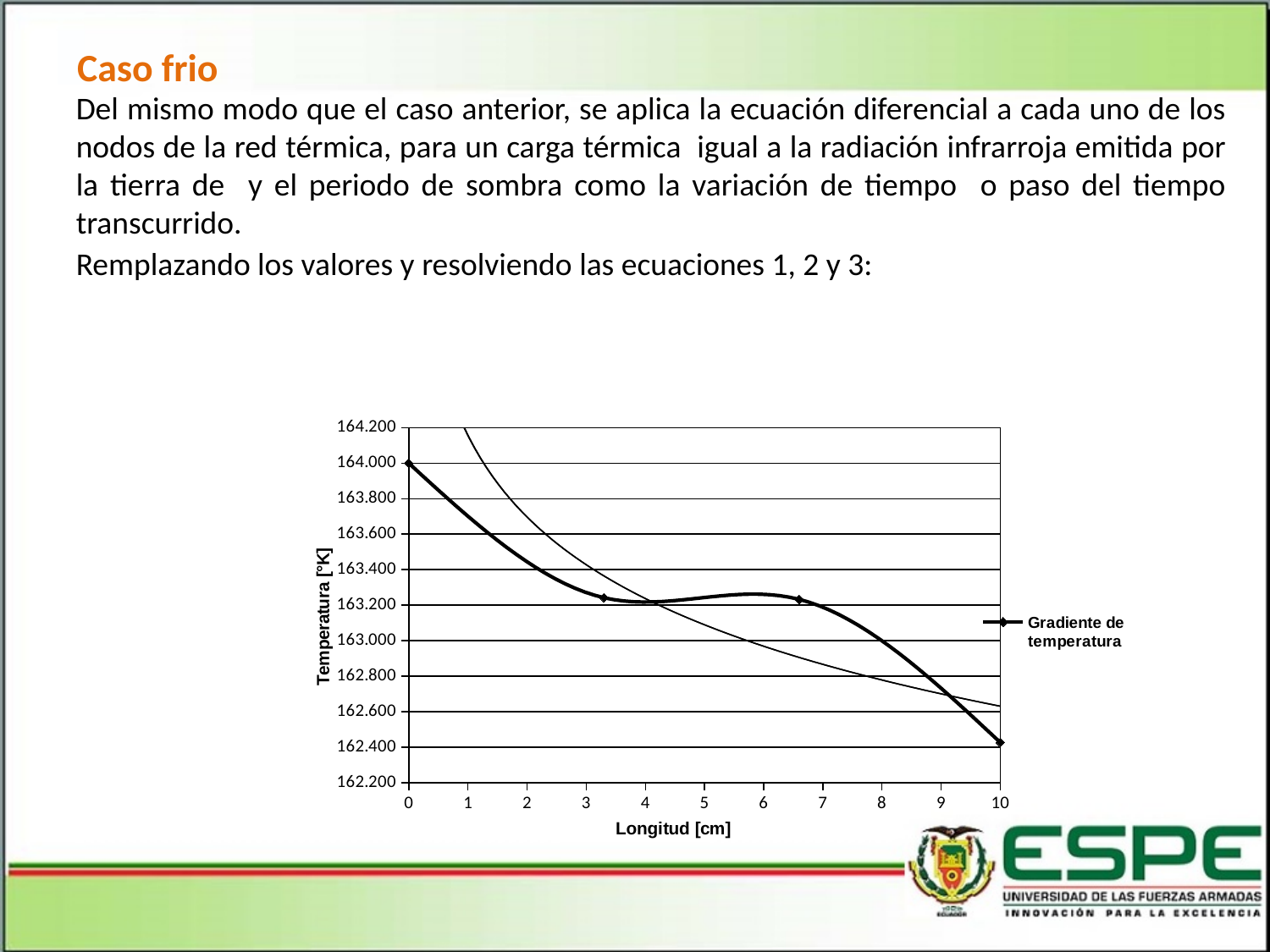
Is the temperature value of the third marked point (near 7 cm) greater or less than 163.400? less How many marked data points does the 'Gradiente de temperatura' series have? 4 Is the temperature value at a length of 10 cm greater or less than 162.600? less Does the temperature generally rise or fall as the length increases from 0 to 10 cm? fall What is the title of the x axis? Longitud [cm] What is the name of the series shown in the legend? Gradiente de temperatura How many series does the chart legend list? 1 Is the temperature value of the second marked point (near 3 cm) greater or less than 163.000? greater Which is larger, the temperature at 0 cm or the temperature at 10 cm? 0 cm What is the temperature value of the 'Gradiente de temperatura' series at a length of 0 cm? 164.000 What kind of chart is shown on the slide? line chart At which length does the 'Gradiente de temperatura' series reach its highest temperature? 0 cm